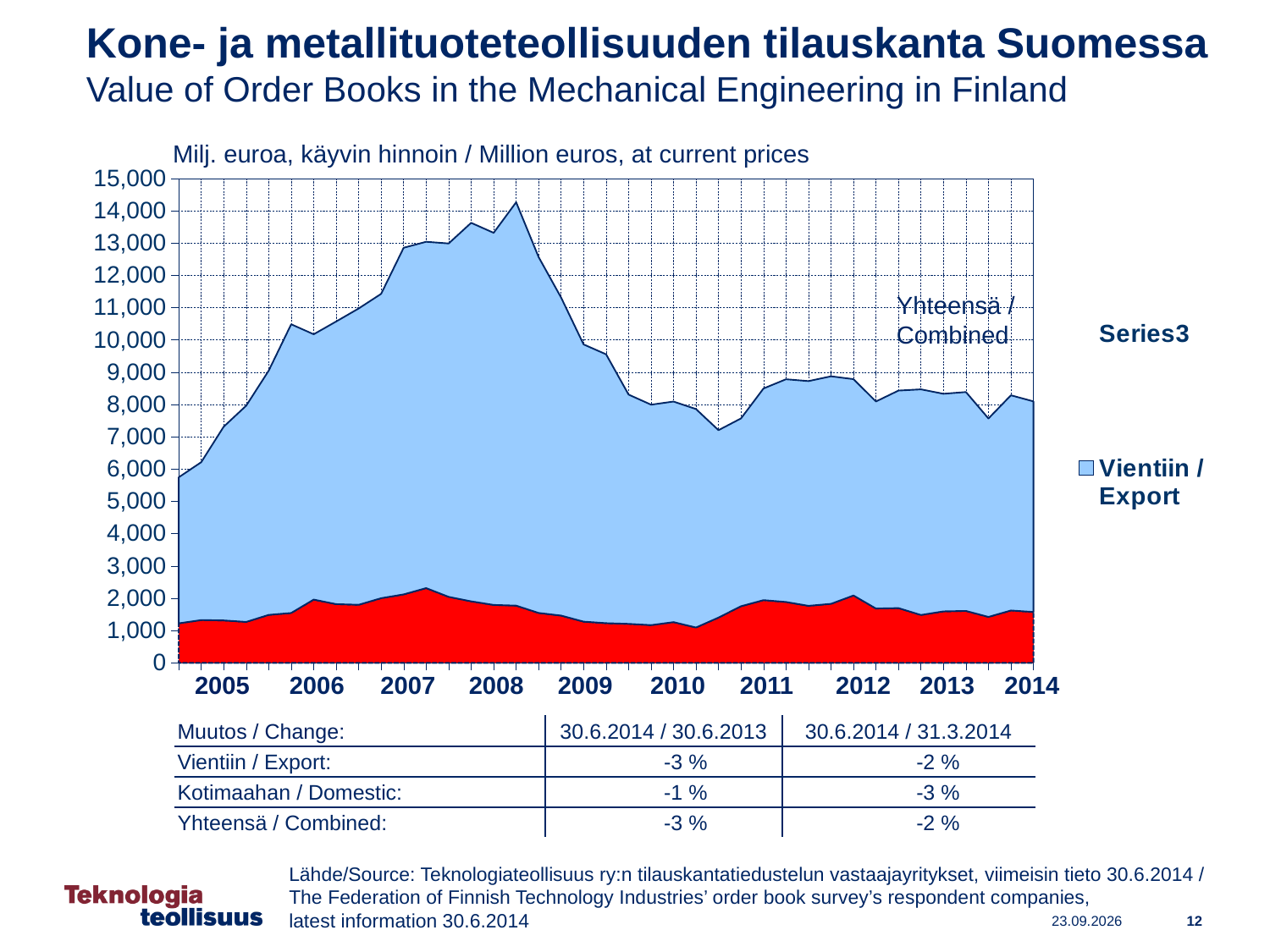
How many series does the chart legend list? 2 Is the combined value at the start of 2005 greater or less than 7,000? less Do the combined values rise or fall between 2008 and 2009? fall Which year has the larger combined value, 2007 or 2012? 2007 Is the red (domestic) area value in 2014 greater or less than 2,000? less In which year does the combined (Yhteensä / Combined) value reach its highest point? 2008 Is the peak combined value in 2008 greater or less than 13,000? greater What kind of chart is shown on the slide? Area chart What unit label is shown above the y axis of the chart? Milj. euroa, käyvin hinnoin / Million euros, at current prices How many years are labelled on the x axis of the chart? 10 In which year is the combined (Yhteensä / Combined) value at its lowest? 2005